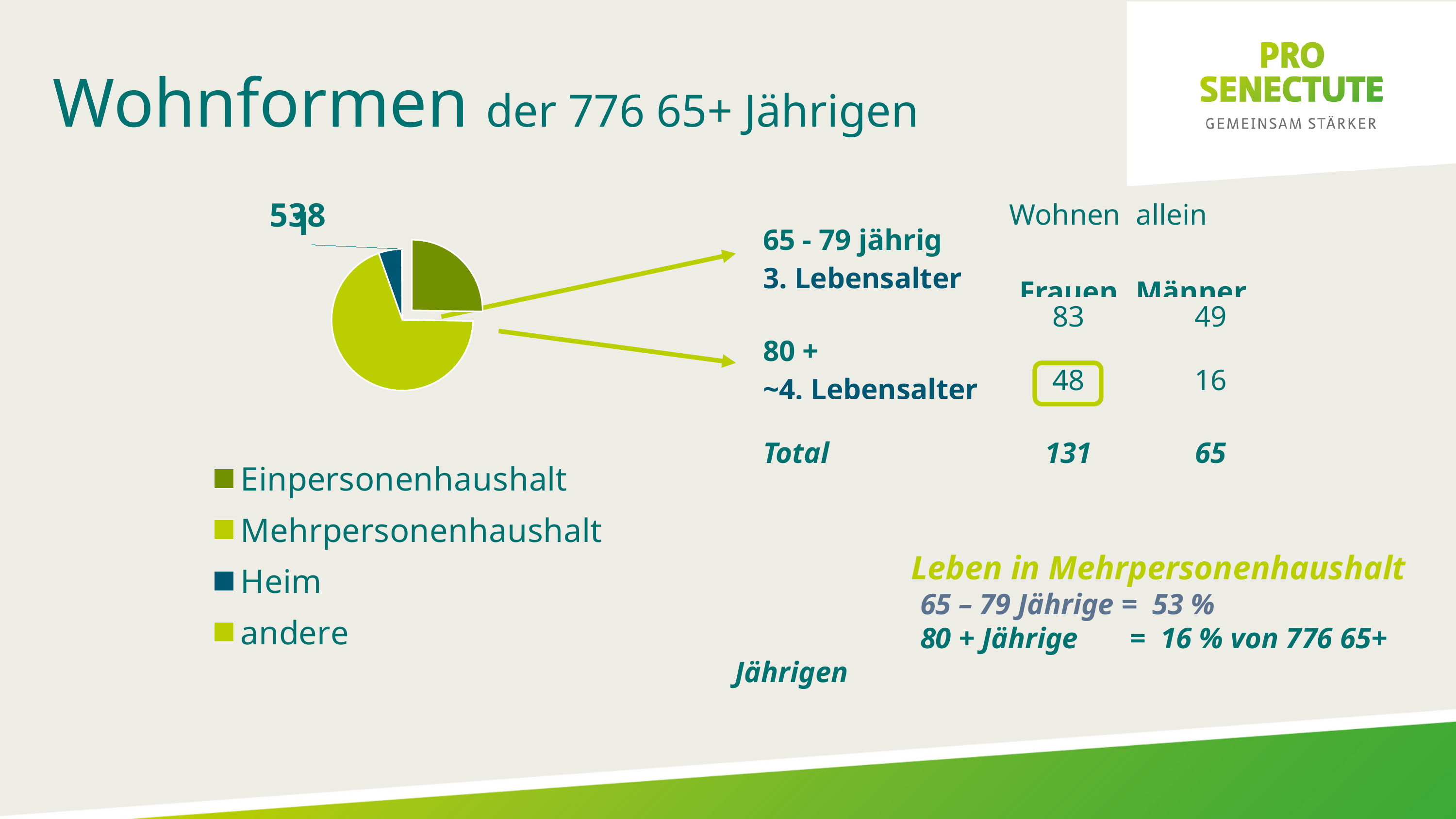
Which category has the largest slice in the pie chart? Mehrpersonenhaushalt Which is larger in the pie chart, the Einpersonenhaushalt slice or the Heim slice? Einpersonenhaushalt How many categories does the legend of the pie chart list? 4 What are the four legend entries of the pie chart? Einpersonenhaushalt, Mehrpersonenhaushalt, Heim, andere Which is larger in the pie chart, the Mehrpersonenhaushalt slice or the Einpersonenhaushalt slice? Mehrpersonenhaushalt Is the Mehrpersonenhaushalt slice greater or less than half of the pie? greater What kind of chart is shown on the slide? pie chart Is the Heim slice greater or less than a quarter of the pie? less What colour is the Heim slice in the pie chart? dark blue